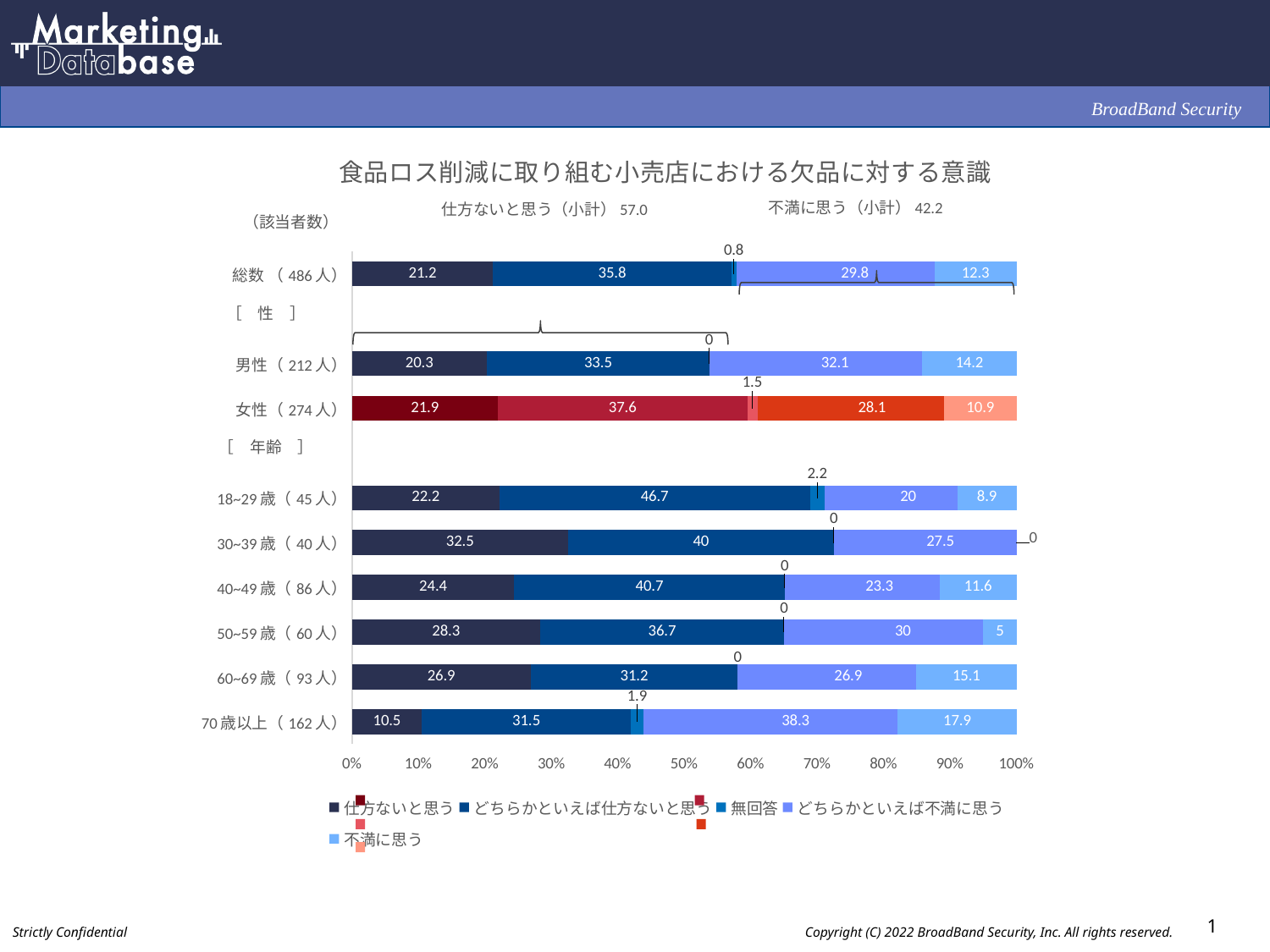
What is the value of 無回答 for 女性 (274人)? 1.5 Which age group has the highest value for 仕方ないと思う? 30~39歳 (40人) How many series does the legend list? 5 Which is larger, the どちらかといえば不満に思う value for 男性 (212人) or for 女性 (274人)? 男性 (212人) Which age group has the highest value for どちらかといえば仕方ないと思う? 18~29歳 (45人) What is the value of 仕方ないと思う for 総数 (486人)? 21.2 What is the difference between the 不満に思う values for 男性 (212人) and 女性 (274人)? 3.3 Which category has the lowest value for 仕方ないと思う? 70歳以上 (162人) What is the value of どちらかといえば不満に思う for 70歳以上 (162人)? 38.3 What is the 不満に思う value for 50~59歳 (60人)? 5 What is the 仕方ないと思う (小計) value shown above the chart? 57.0 What type of chart is shown on the slide? Stacked bar chart